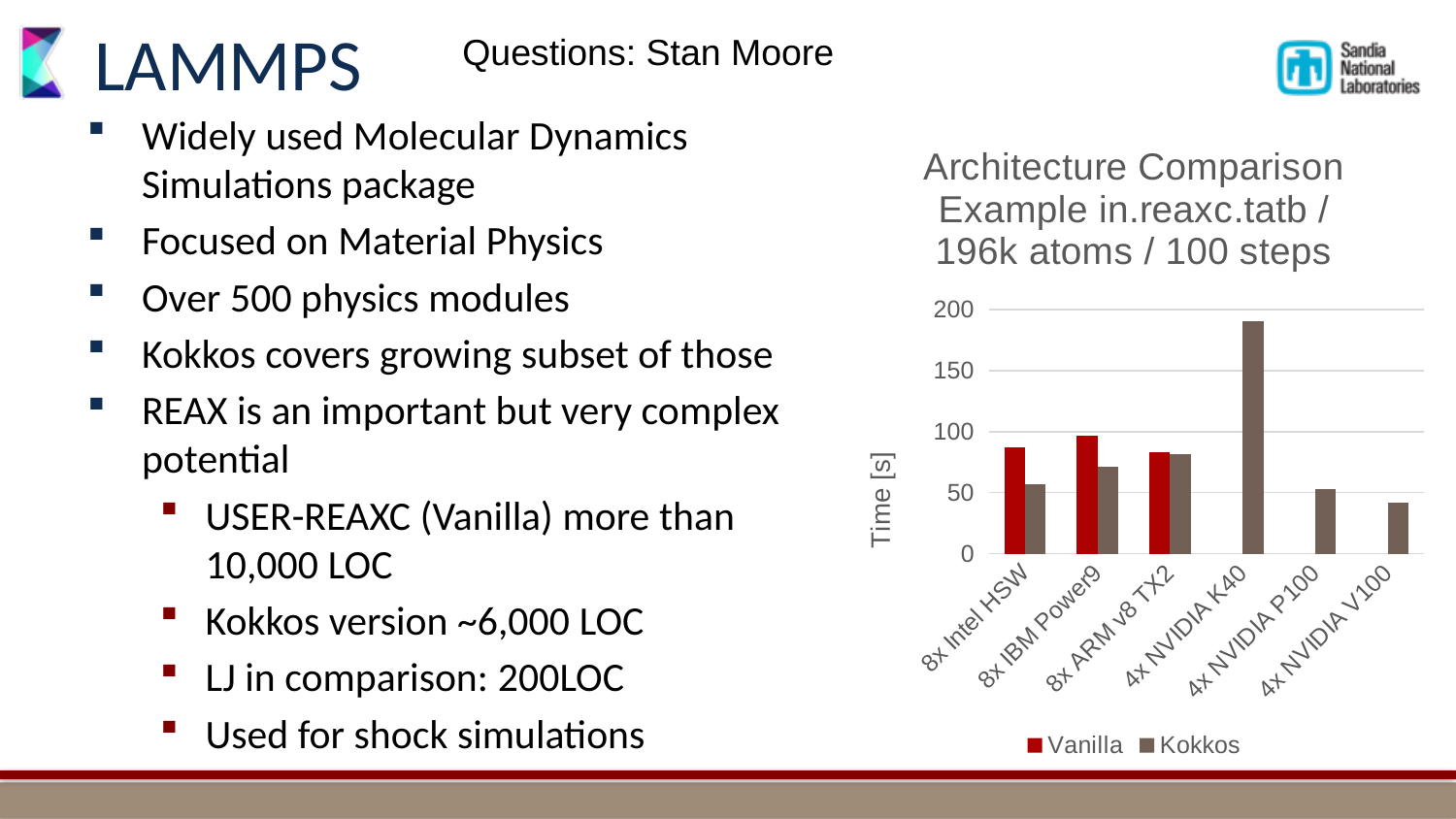
What is the label of the y axis? Time [s] Which architecture has the lowest Kokkos time? 4x NVIDIA V100 Is the Vanilla value for 8x Intel HSW greater or less than 50? greater Which architecture has the highest Kokkos time? 4x NVIDIA K40 For 8x IBM Power9, which is larger, the Vanilla time or the Kokkos time? Vanilla Is the Kokkos value for 4x NVIDIA K40 greater or less than 150? greater For 8x Intel HSW, which is larger, the Vanilla time or the Kokkos time? Vanilla What kind of chart is shown on the slide? Bar chart How many series does the legend list? 2 Is the Kokkos value for 4x NVIDIA V100 greater or less than 50? less How many architectures (categories) are shown on the x axis? 6 How many architectures have a Vanilla bar plotted? 3